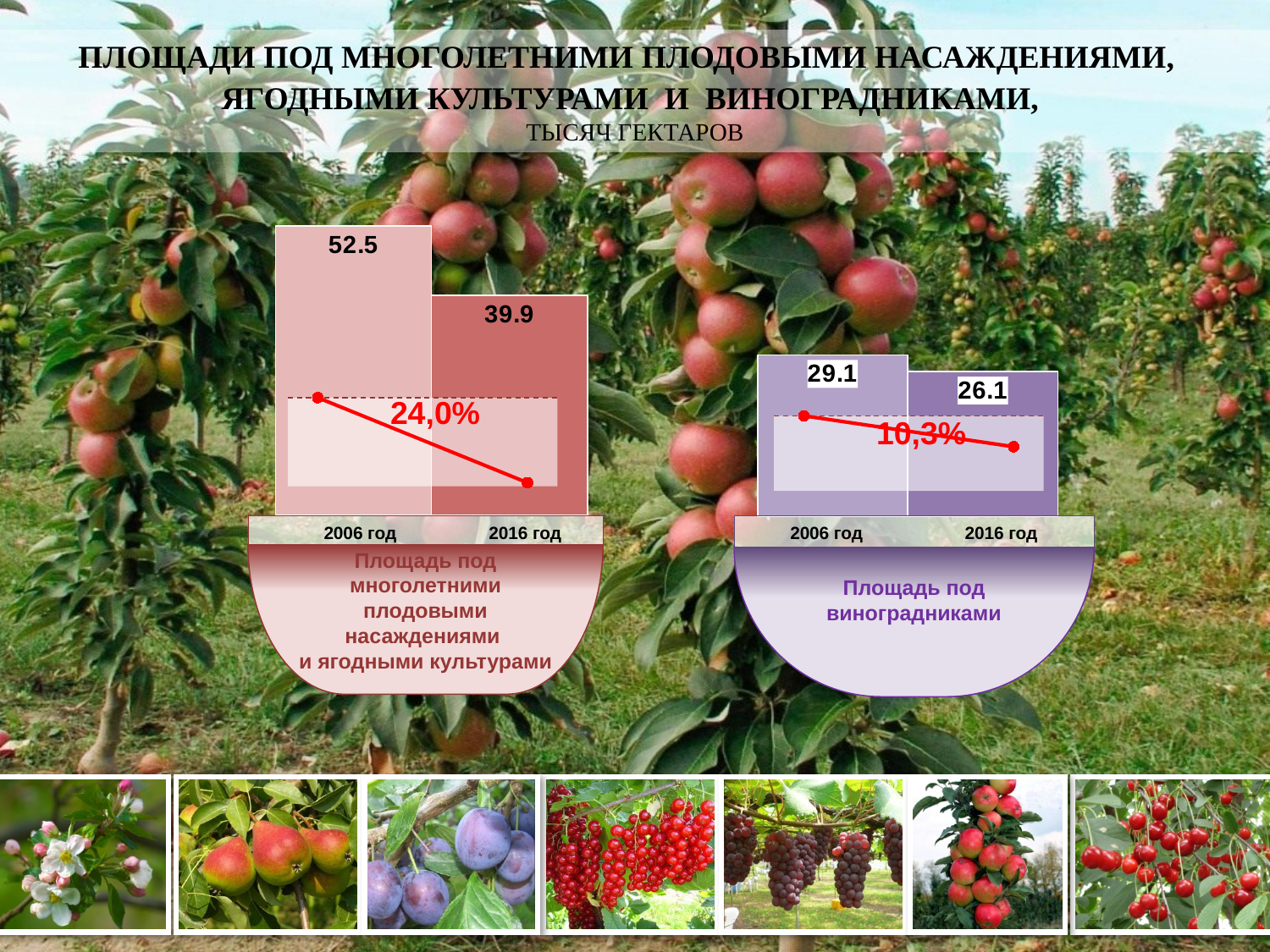
On the right chart (Площадь под виноградниками), what is the value for 2016 год? 26.1 On the right chart (Площадь под виноградниками), which year has the lower value? 2016 год On the right chart (Площадь под виноградниками), what is the difference between the 2006 and 2016 values? 3.0 On the left chart (Площадь под многолетними плодовыми насаждениями и ягодными культурами), which year has the higher value? 2006 год On the right chart (Площадь под виноградниками), do the values rise or fall from 2006 to 2016? fall On the left chart (Площадь под многолетними плодовыми насаждениями и ягодными культурами), what is the value for 2016 год? 39.9 On the left chart (Площадь под многолетними плодовыми насаждениями и ягодными культурами), what is the value for 2006 год? 52.5 On the right chart (Площадь под виноградниками), what is the value for 2006 год? 29.1 What kind of chart is used on the left (Площадь под многолетними плодовыми насаждениями и ягодными культурами)? bar chart On the left chart (Площадь под многолетними плодовыми насаждениями и ягодными культурами), what is the difference between the 2006 and 2016 values? 12.6 On the left chart (Площадь под многолетними плодовыми насаждениями и ягодными культурами), what percentage change is printed between 2006 and 2016? 24,0% On the right chart (Площадь под виноградниками), what percentage change is printed between 2006 and 2016? 10,3%